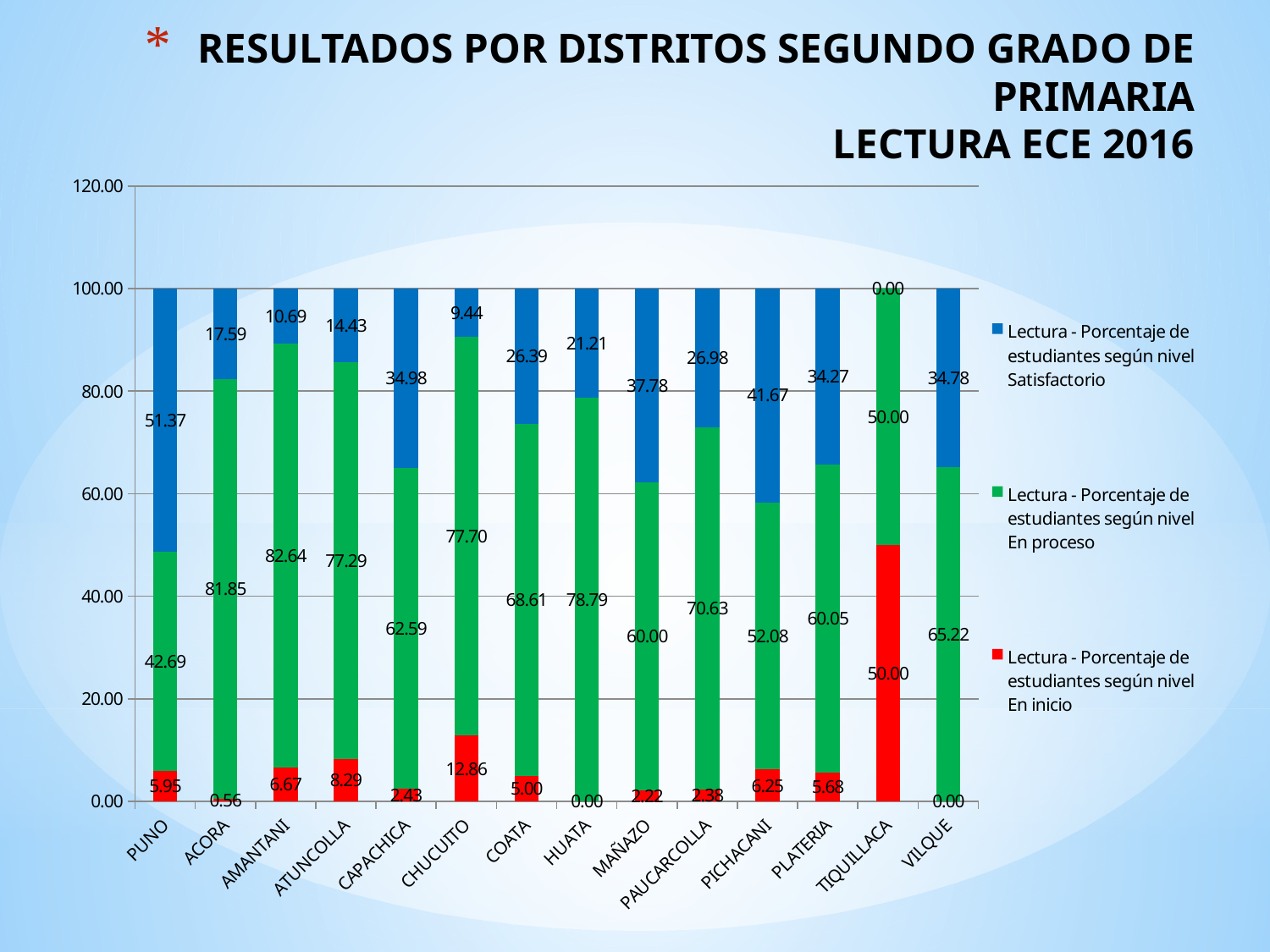
How many series does the legend list? 3 What kind of chart is shown? Stacked bar chart Which district has the lowest Satisfactorio value? TIQUILLACA Which colour represents the En proceso series? Green Which district has the highest En inicio value? TIQUILLACA How many districts are shown on the x axis? 14 Which district has the highest Satisfactorio value? PUNO What is the En proceso value for VILQUE? 65.22 What is the Satisfactorio value for PUNO? 51.37 What is the difference between the Satisfactorio values for PICHACANI and MAÑAZO? 3.89 Which is larger, the Satisfactorio value for CAPACHICA or for PLATERIA? CAPACHICA What is the En inicio value for CHUCUITO? 12.86